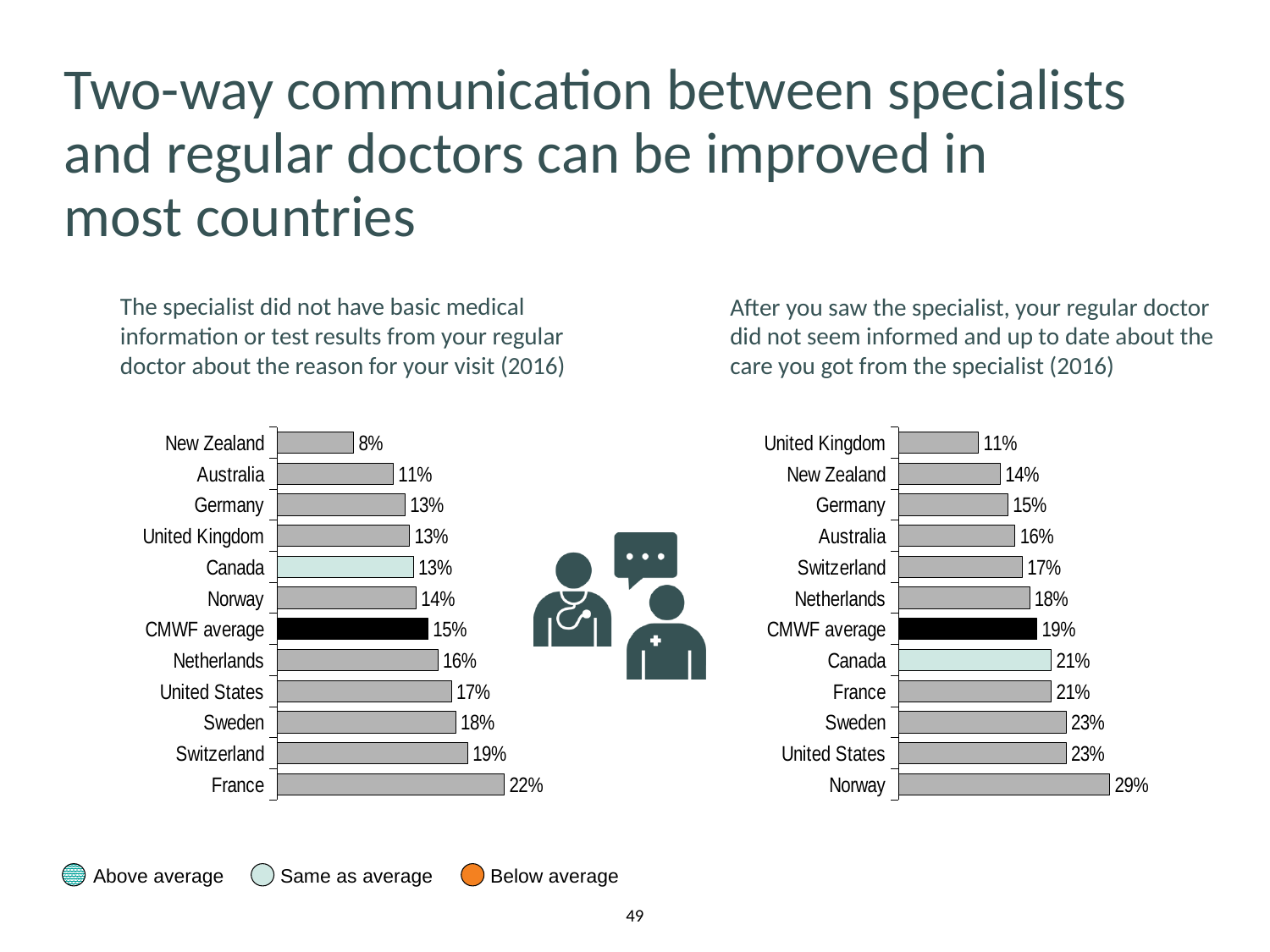
In the left chart (specialist did not have basic medical information), what is the CMWF average? 15% In the left chart (specialist did not have basic medical information), which country has the lowest value? New Zealand How many bars (including the CMWF average) are shown in the right chart (regular doctor did not seem informed)? 12 In the right chart (regular doctor did not seem informed), what is the value for Norway? 29% In the left chart (specialist did not have basic medical information), what is the value for Canada? 13% In the right chart (regular doctor did not seem informed), which is larger, the value for Canada or the value for Germany? Canada In the right chart (regular doctor did not seem informed), what is the difference between Norway and the CMWF average? 10% In the left chart (specialist did not have basic medical information), what is the difference between France and New Zealand? 14% In the right chart (regular doctor did not seem informed), which country has the lowest value? United Kingdom In the left chart (specialist did not have basic medical information), what is the value for Switzerland? 19% What type of chart is used on the left side of the slide? Bar chart In the left chart (specialist did not have basic medical information), which country has the highest value? France